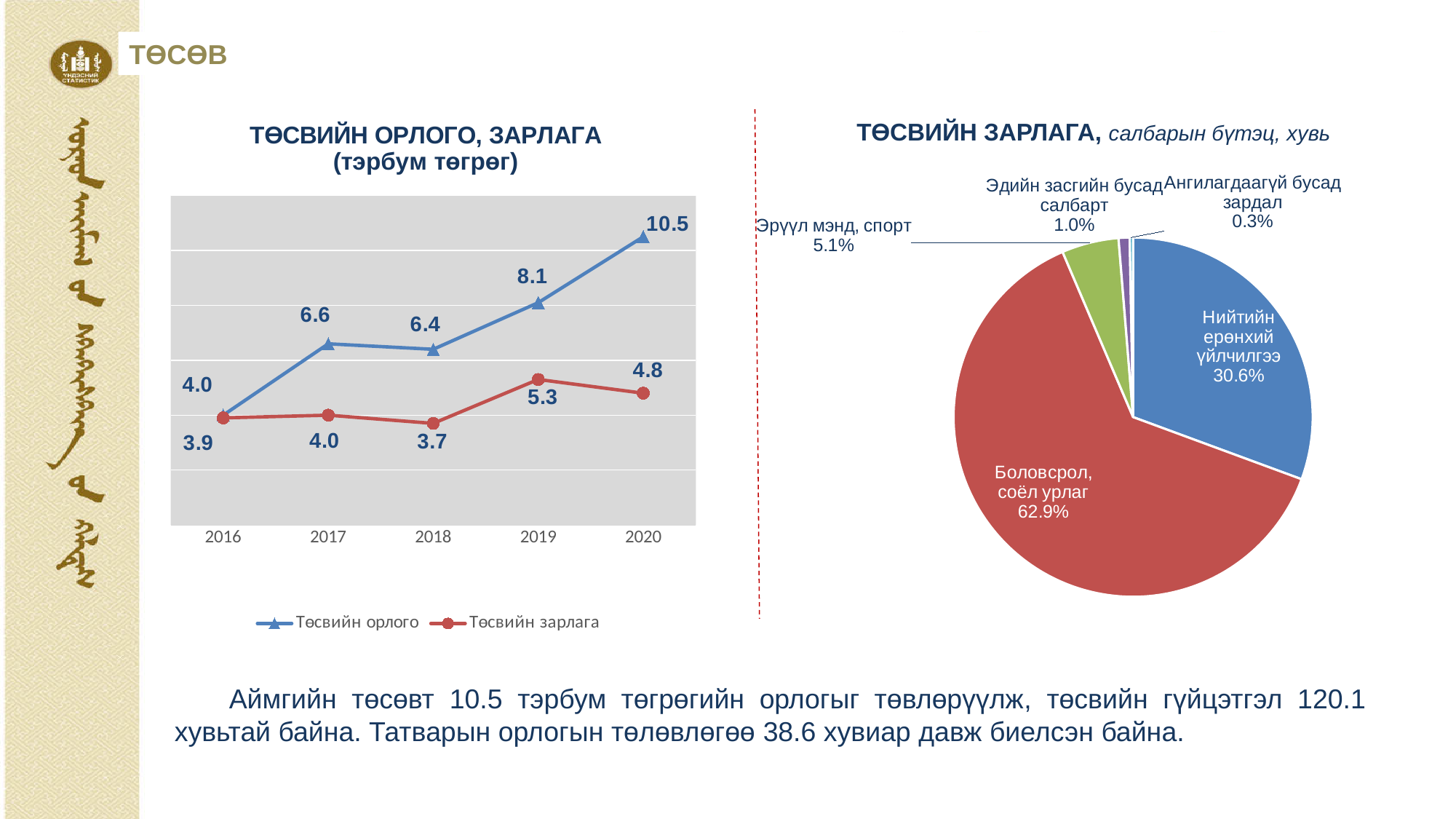
In the line chart 'ТӨСВИЙН ОРЛОГО, ЗАРЛАГА', in which year is Төсвийн зарлага highest? 2019 In the line chart 'ТӨСВИЙН ОРЛОГО, ЗАРЛАГА', how many series does the legend list? 2 In the line chart 'ТӨСВИЙН ОРЛОГО, ЗАРЛАГА', what is the value of Төсвийн зарлага in 2018? 3.7 What kind of chart is the chart on the left of the slide? Line chart In the line chart 'ТӨСВИЙН ОРЛОГО, ЗАРЛАГА', does Төсвийн орлого rise or fall from 2018 to 2020? Rise In the line chart 'ТӨСВИЙН ОРЛОГО, ЗАРЛАГА', what is the value of Төсвийн орлого in 2020? 10.5 In the pie chart 'ТӨСВИЙН ЗАРЛАГА, салбарын бүтэц, хувь', which slice is the smallest? Ангилагдаагүй бусад зардал In the pie chart 'ТӨСВИЙН ЗАРЛАГА, салбарын бүтэц, хувь', what share does Боловсрол, соёл урлаг have? 62.9% In the line chart 'ТӨСВИЙН ОРЛОГО, ЗАРЛАГА', in which year is Төсвийн орлого lowest? 2016 In the line chart 'ТӨСВИЙН ОРЛОГО, ЗАРЛАГА', which is larger in 2017: Төсвийн орлого or Төсвийн зарлага? Төсвийн орлого In the line chart 'ТӨСВИЙН ОРЛОГО, ЗАРЛАГА', how many years are shown on the x axis? 5 In the line chart 'ТӨСВИЙН ОРЛОГО, ЗАРЛАГА', what is the difference between Төсвийн орлого and Төсвийн зарлага in 2020? 5.7